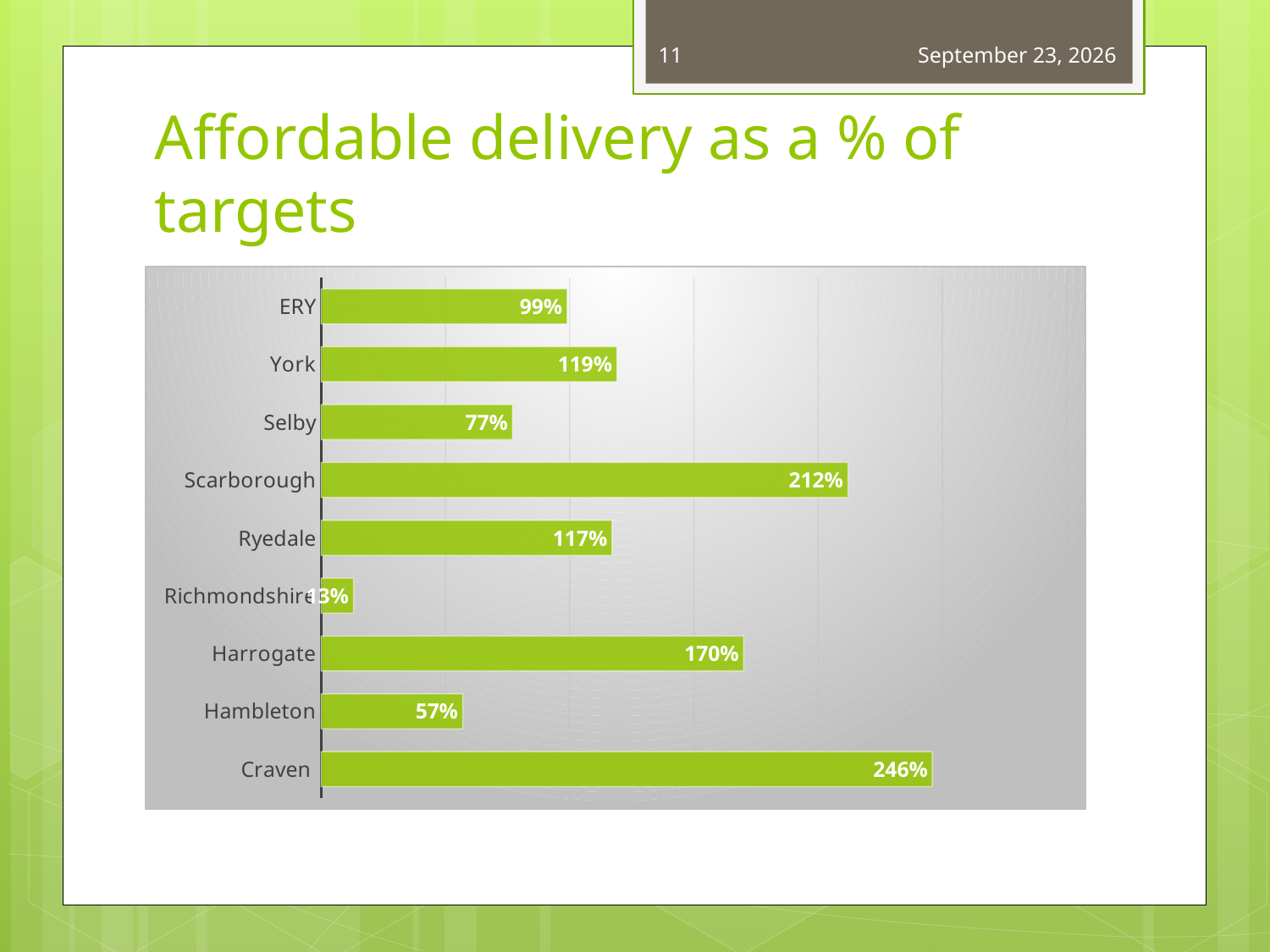
What is the title of the slide containing the chart? Affordable delivery as a % of targets What is the value for York? 119% What is the difference between the values for Harrogate and Hambleton? 113% Which category has the lowest value? Richmondshire What is the value for Craven? 246% Which is larger, the value for York or the value for Ryedale? York What is the value for Scarborough? 212% What is the difference between the values for Craven and Scarborough? 34% What kind of chart is shown on the slide? Bar chart How many categories are shown in the chart? 9 Which category has the highest value? Craven What is the value for Hambleton? 57%